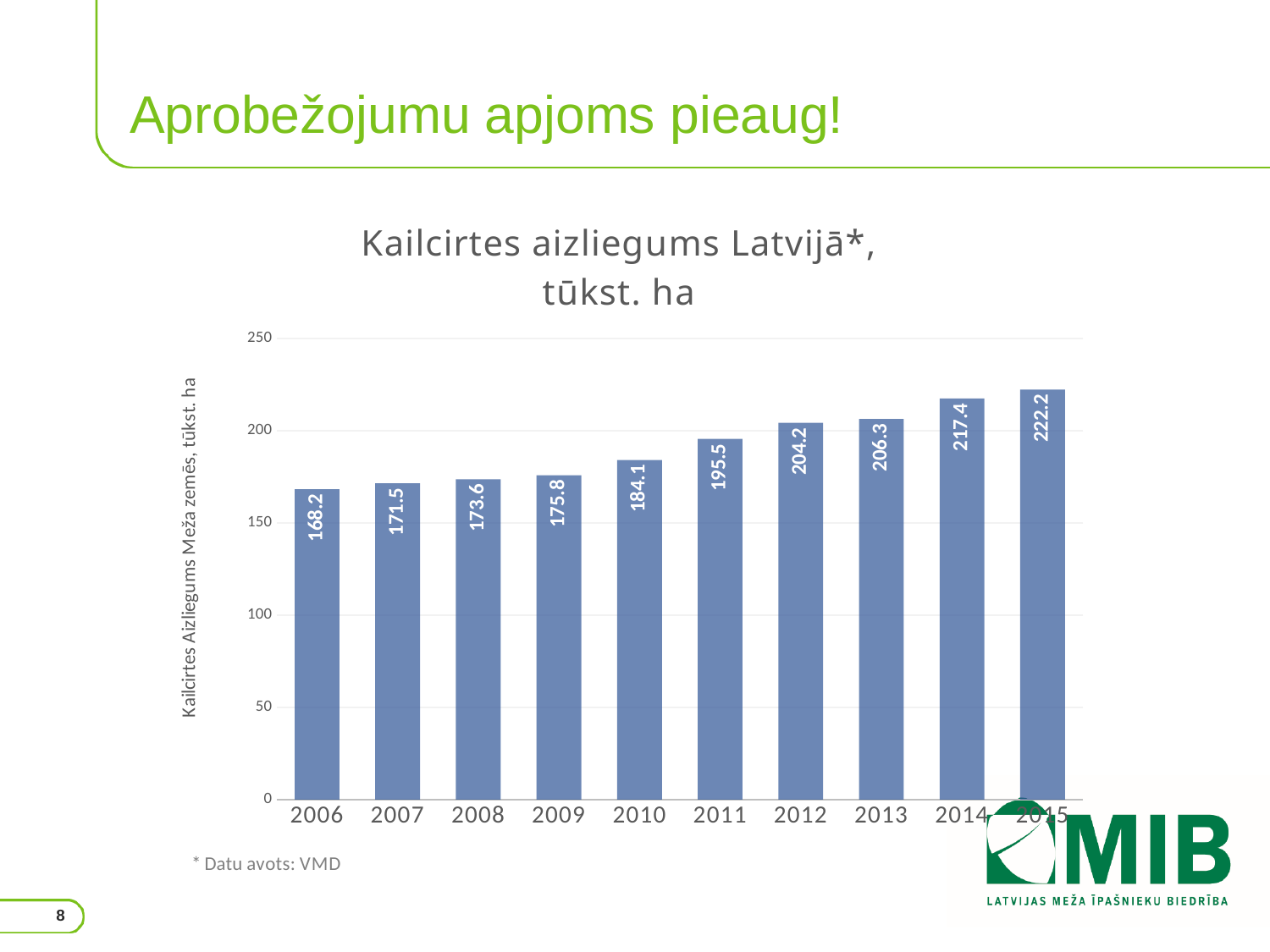
Do the values rise or fall from 2006 to 2015? rise Which year has the lowest value? 2006 What is the value for 2006? 168.2 Which year has the highest value? 2015 What is the difference between the values for 2012 and 2011? 8.7 What is the difference between the values for 2015 and 2006? 54 Which is larger, the value for 2009 or the value for 2013? 2013 What is the value for 2015? 222.2 What is the value for 2011? 195.5 Is the value for 2014 greater or less than 200? greater How many years are shown on the x axis? 10 What kind of chart is shown on the slide? bar chart